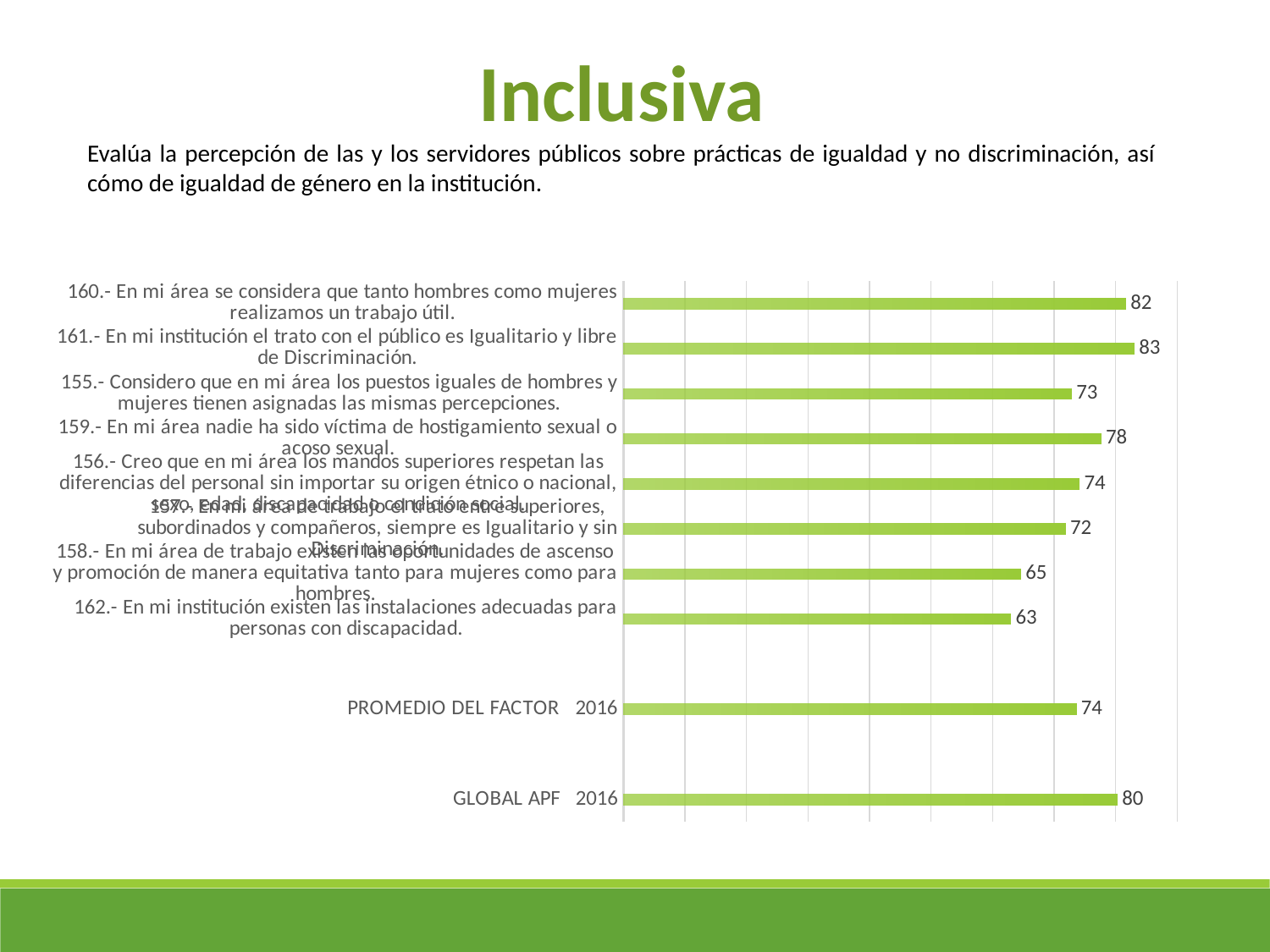
What value is shown for item 162 ("En mi institución existen las instalaciones adecuadas para personas con discapacidad")? 63 Which item has the highest value in the chart? 161.- En mi institución el trato con el público es Igualitario y libre de Discriminación. What is the difference between the values for item 161 and item 162? 20 What value is shown for PROMEDIO DEL FACTOR 2016? 74 What value is shown for item 161 ("En mi institución el trato con el público es Igualitario y libre de Discriminación")? 83 What is the difference between the GLOBAL APF 2016 value and the PROMEDIO DEL FACTOR 2016 value? 6 What value is shown for GLOBAL APF 2016? 80 How many bars are plotted in the chart? 10 What type of chart is shown on the slide? Bar chart Which is larger: the value for item 160 or the value for item 155? Item 160 (82) Which item has the lowest value in the chart? 162.- En mi institución existen las instalaciones adecuadas para personas con discapacidad. What value is shown for item 159 ("En mi área nadie ha sido víctima de hostigamiento sexual o acoso sexual")? 78